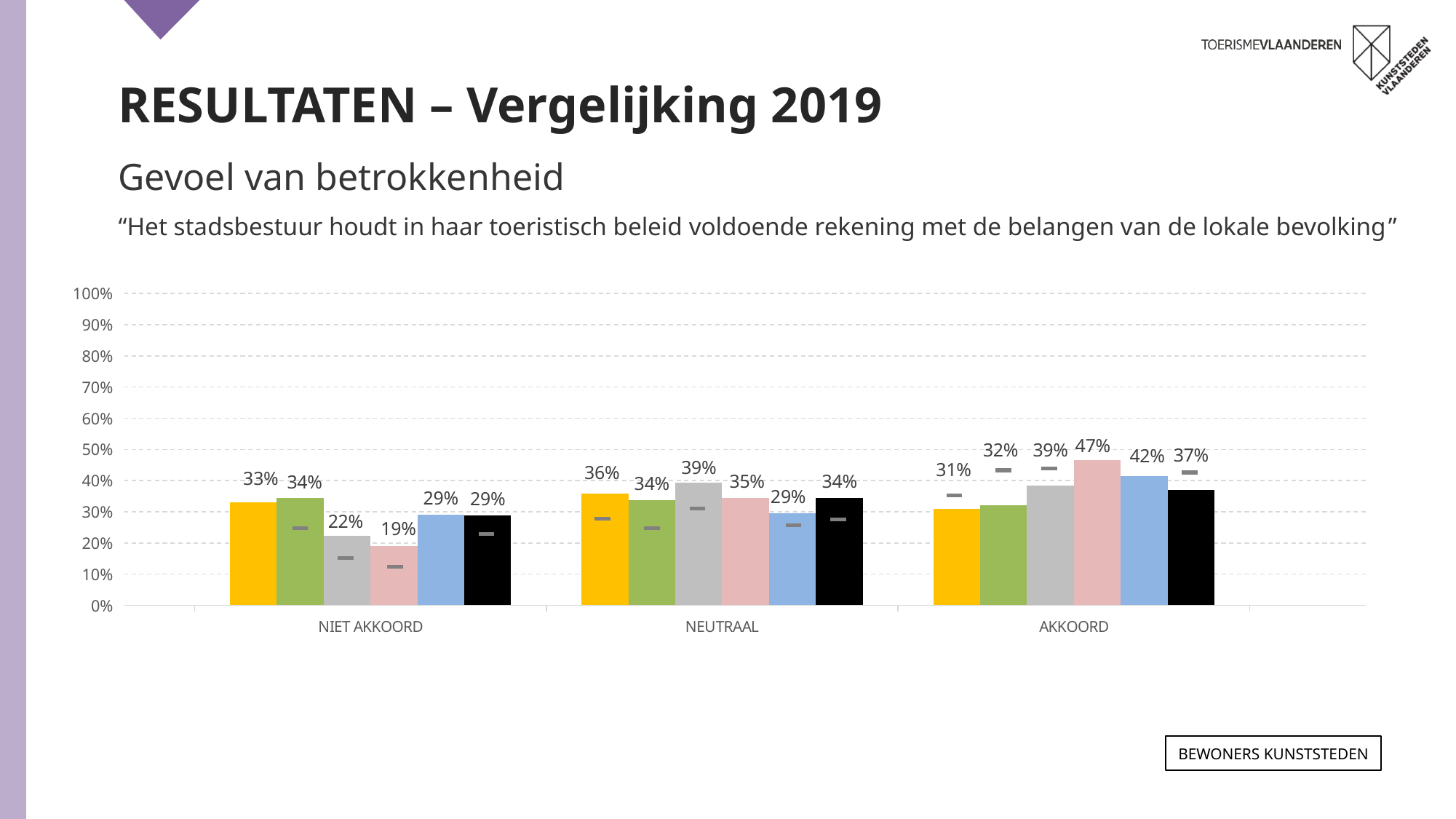
What kind of chart is shown on the slide? bar chart Is the value of the blue bar in the AKKOORD category greater or less than 40%? greater Which bar has the lowest value in the NIET AKKOORD category? the pink bar (19%) How many bars are plotted in each category of the chart? 6 Which bar has the highest value in the AKKOORD category? the pink bar (47%) What is the difference between the pink bar in AKKOORD (47%) and the pink bar in NIET AKKOORD (19%)? 28% How many categories are shown on the x axis of the chart? 3 What is the label of the middle category on the x axis of the chart? NEUTRAAL What is the value of the yellow bar in the NEUTRAAL category? 36% Which is larger: the grey bar in NEUTRAAL or the grey bar in NIET AKKOORD? the grey bar in NEUTRAAL (39%) What is the value of the pink bar in the AKKOORD category? 47% What is the value of the pink bar in the NIET AKKOORD category? 19%